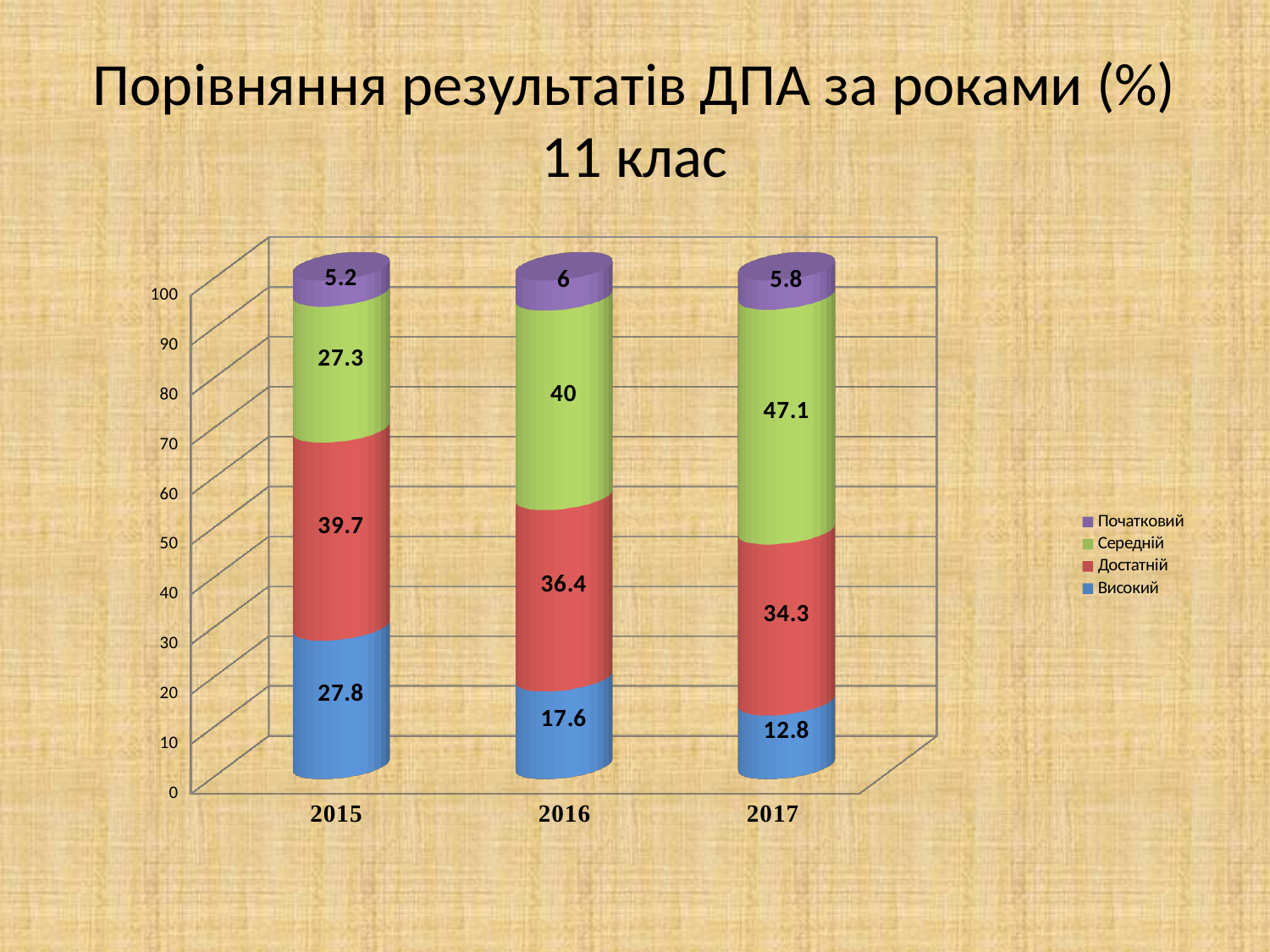
What is the value for Початковий in 2016? 6 What is the value for Достатній in 2016? 36.4 What is the value for Високий in 2015? 27.8 How many years are shown on the x axis? 3 How many series does the legend list? 4 In which year is the Середній value the highest? 2017 In which year is the Високий value the lowest? 2017 Does the Високий value rise or fall from 2015 to 2017? Fall Which is larger, the Високий value for 2015 or for 2016? 2015 What is the value for Середній in 2017? 47.1 What is the difference between the Достатній values for 2015 and 2017? 5.4 What kind of chart is shown on the slide? Stacked bar chart